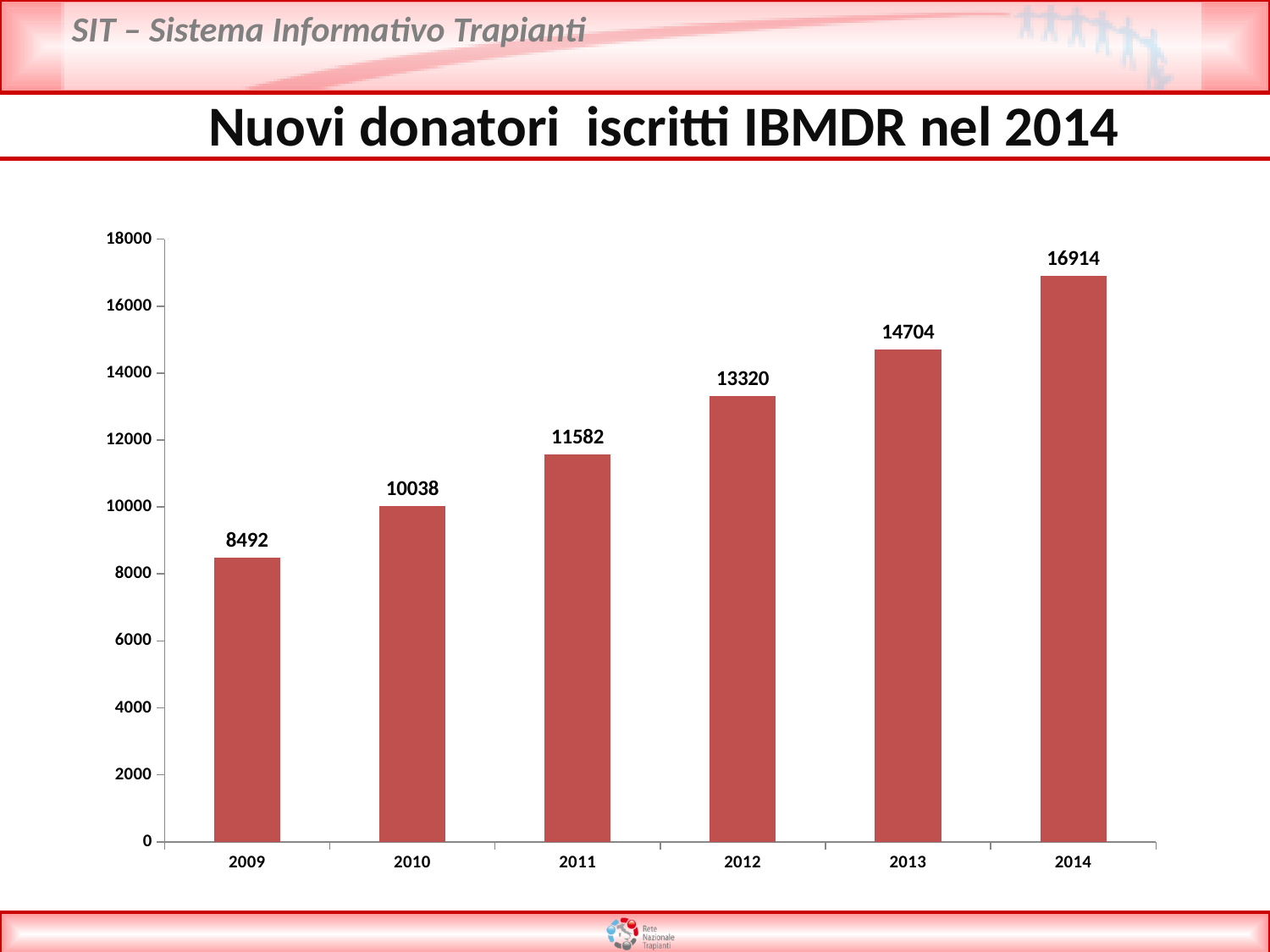
Which year has the highest value? 2014 What is the difference between the values for 2014 and 2013? 2210 What is the value for 2012? 13320 Which is larger, the value for 2012 or the value for 2011? 2012 What is the difference between the values for 2011 and 2010? 1544 What kind of chart is shown on the slide? bar chart How many years are shown on the x axis? 6 What is the value for 2014? 16914 Is the value for 2013 greater or less than 14000? greater What is the value for 2009? 8492 Which year has the lowest value? 2009 Do the values rise or fall from 2009 to 2014? rise